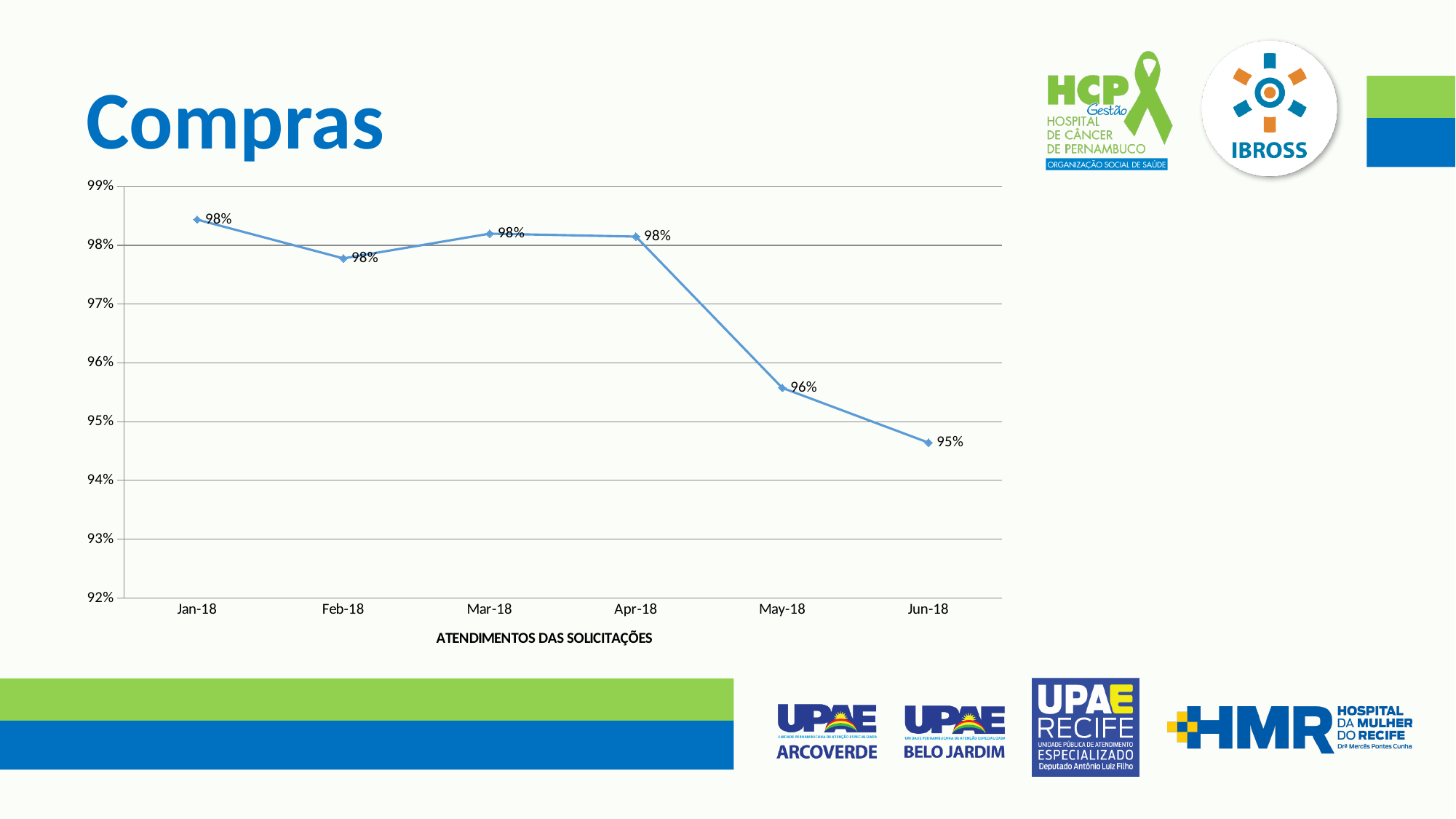
Is the value for Feb-18 greater or less than 97%? greater Do the values rise or fall from Apr-18 to Jun-18? fall Which month has the lowest value? Jun-18 What kind of chart is shown on the slide? line chart What is the difference between the value for Apr-18 and the value for Jun-18? 3% How many months are plotted on the chart? 6 What is the value for May-18? 96% What is the value for Jan-18? 98% Which is larger, the value for Apr-18 or the value for May-18? Apr-18 What is the value for Jun-18? 95% Is the value for Jun-18 greater or less than 94%? greater Which is larger, the value for Jan-18 or the value for Jun-18? Jan-18